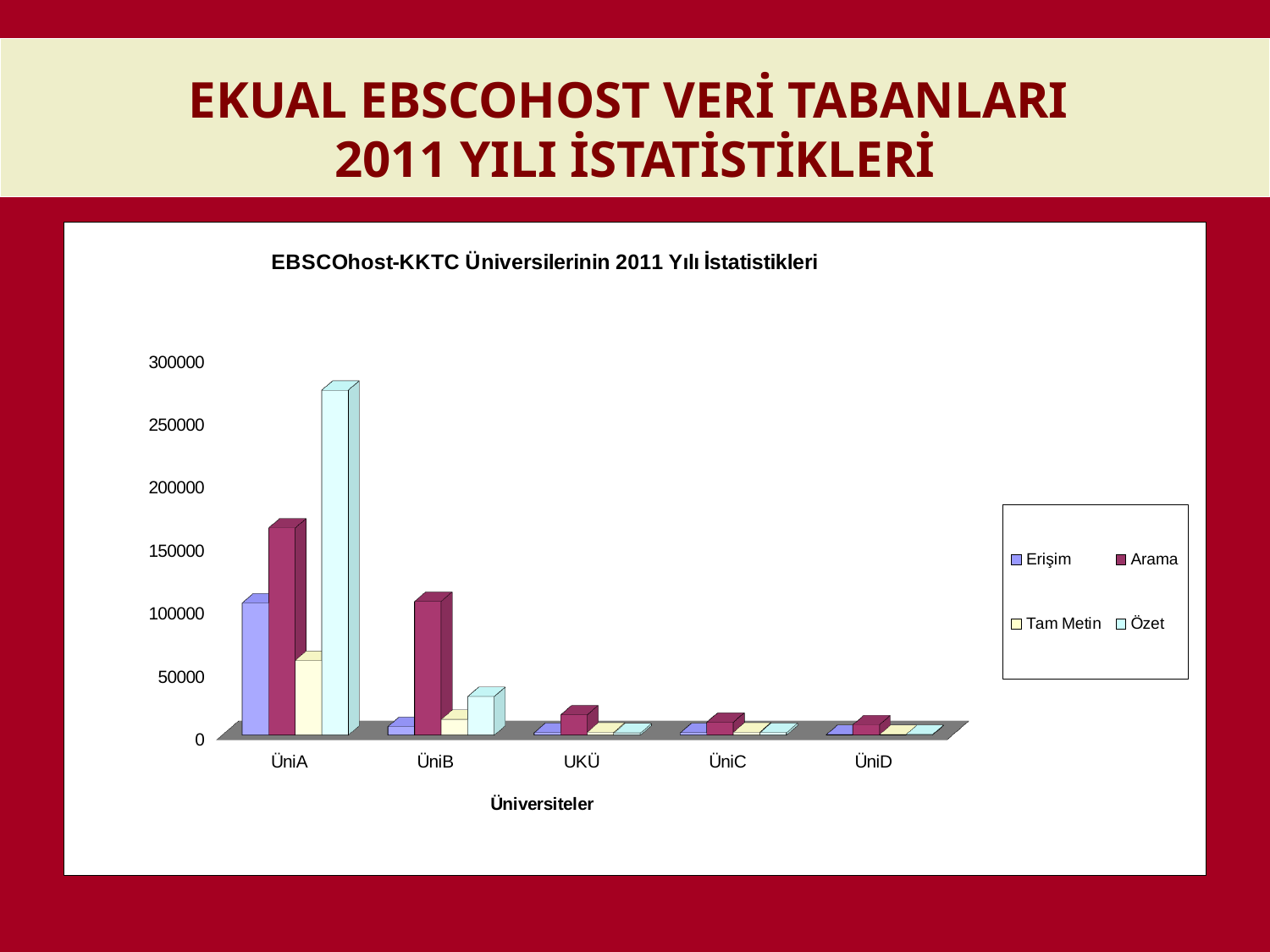
Which university has the highest Özet value? ÜniA Which is larger, the Arama value for ÜniA or the Arama value for ÜniB? ÜniA Which university has the highest Arama value? ÜniA How many universities are shown on the x axis of the chart? 5 How many series does the chart's legend list? 4 Is the Özet value for ÜniB greater or less than 50000? less What kind of chart is shown on the slide? bar chart Which is larger, the Özet value for ÜniA or the Erişim value for ÜniA? Özet Is the Tam Metin value for ÜniA greater or less than 50000? greater Is the Özet value for ÜniA greater or less than 250000? greater What is the label of the x axis of the chart? Üniversiteler